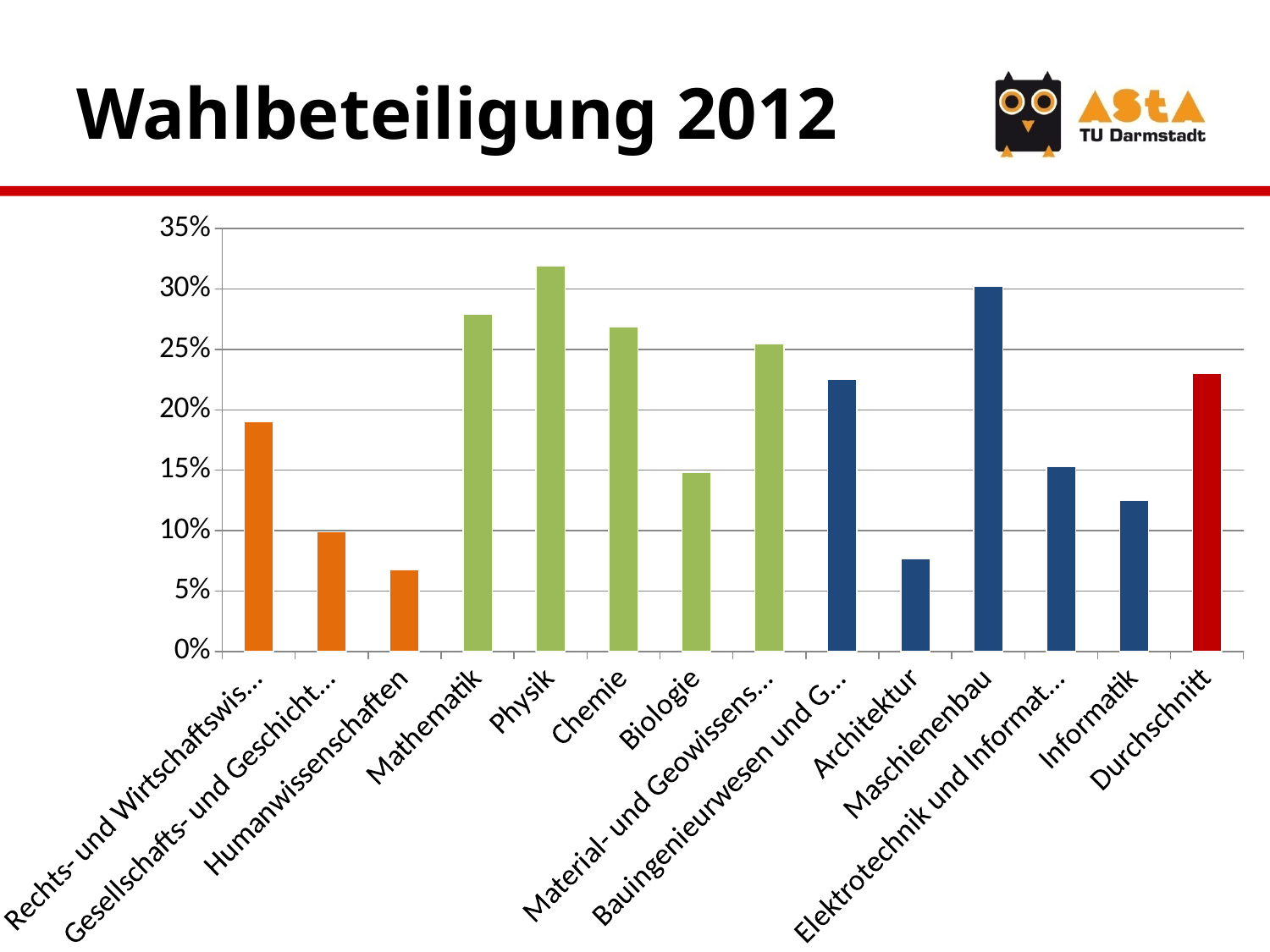
Is the value for Humanwissenschaften greater or less than 10%? less Is the value for Durchschnitt greater or less than 20%? greater What is the title of the slide containing the chart? Wahlbeteiligung 2012 How many bars are plotted in the chart? 14 Is the value for Architektur greater or less than 10%? less Which is larger, the value for Chemie or the value for Biologie? Chemie What colour is the bar for Durchschnitt? red Which category has the highest value in the chart? Physik What kind of chart is shown on the slide? bar chart Which is larger, the value for Informatik or the value for Maschinenbau? Maschinenbau